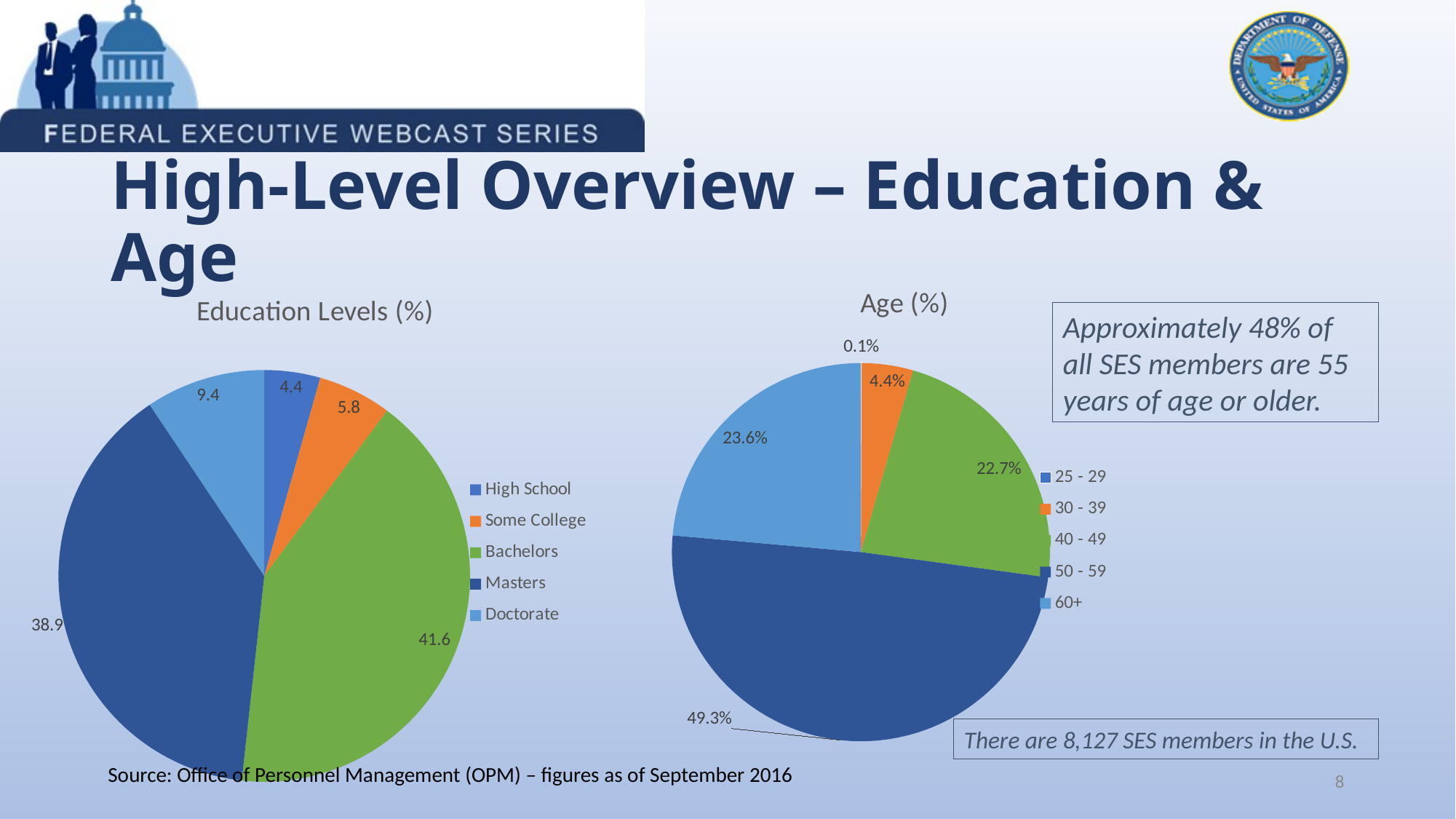
In the Age (%) chart, what is the value for the 30 - 39 age group? 4.4% In the Education Levels (%) chart, which education level has the largest slice? Bachelors In the Education Levels (%) chart, what is the difference between the Bachelors and Masters values? 2.7 In the Education Levels (%) chart, which education level has the smallest slice? High School In the Age (%) chart, which is larger, the 40 - 49 slice or the 60+ slice? 60+ In the Education Levels (%) chart, what is the value for Bachelors? 41.6 In the Age (%) chart, which age group has the smallest share? 25 - 29 In the Education Levels (%) chart, what is the value for Doctorate? 9.4 In the Age (%) chart, what is the difference between the 50 - 59 and 60+ values? 25.7% What type of chart is the Age (%) chart? Pie chart In the Age (%) chart, what is the value for the 50 - 59 age group? 49.3% In the Education Levels (%) chart, how many education categories are shown? 5